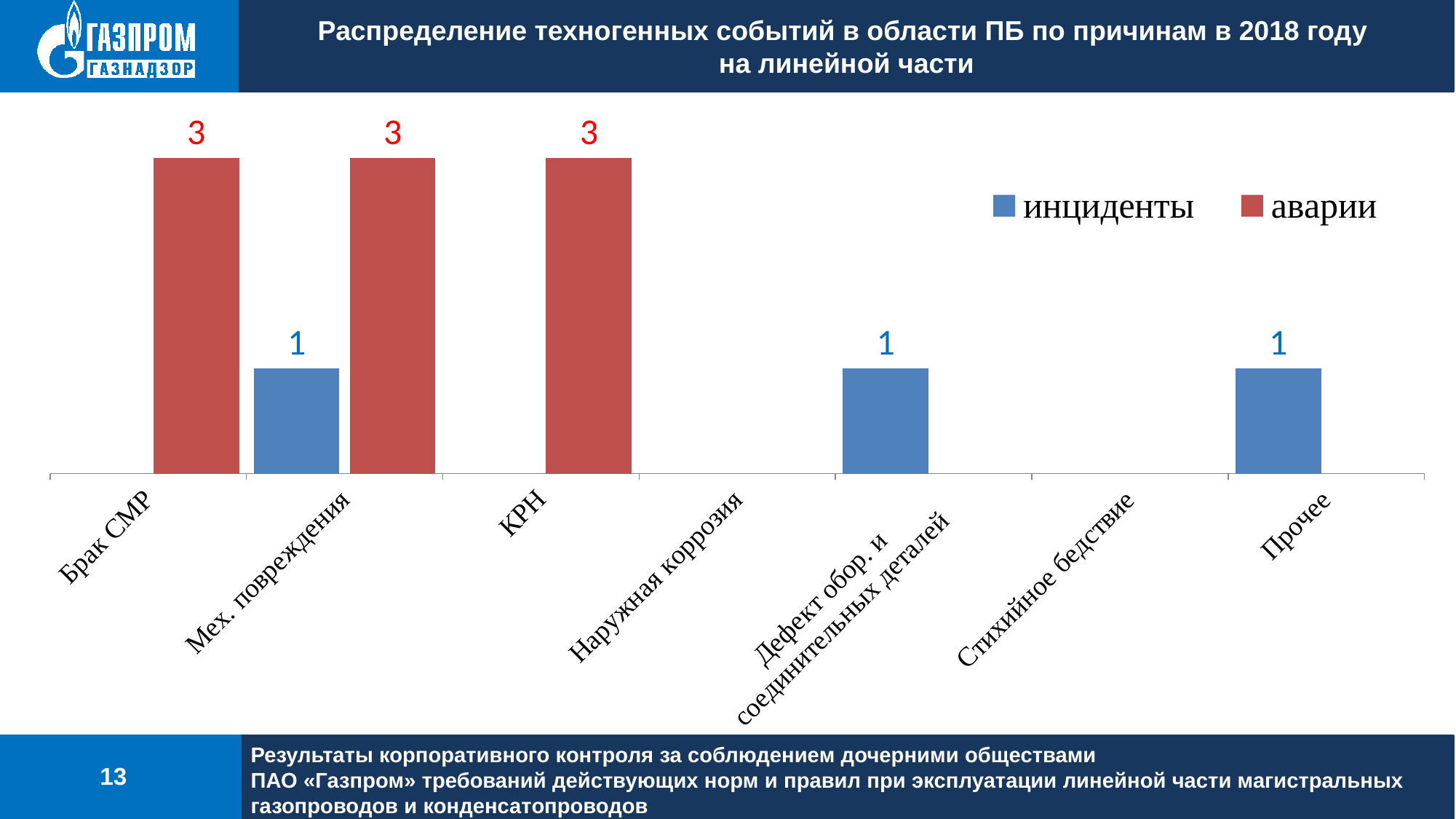
What kind of chart is shown on the slide? bar chart What is the difference between аварии and инциденты for Мех. повреждения? 2 Which category has the lowest value of инциденты among those with a visible инциденты bar, Мех. повреждения or Дефект обор. и соединительных деталей, or are they equal? equal Which is larger for Мех. повреждения, аварии or инциденты? аварии What is the value of аварии for КРН? 3 How many categories are shown on the x axis? 7 How many series does the legend list? 2 What is the title of the chart? Распределение техногенных событий в области ПБ по причинам в 2018 году на линейной части What is the value of инциденты for Мех. повреждения? 1 Which series is shown in red in the legend? аварии What is the value of инциденты for Прочее? 1 What is the value of аварии for Брак СМР? 3